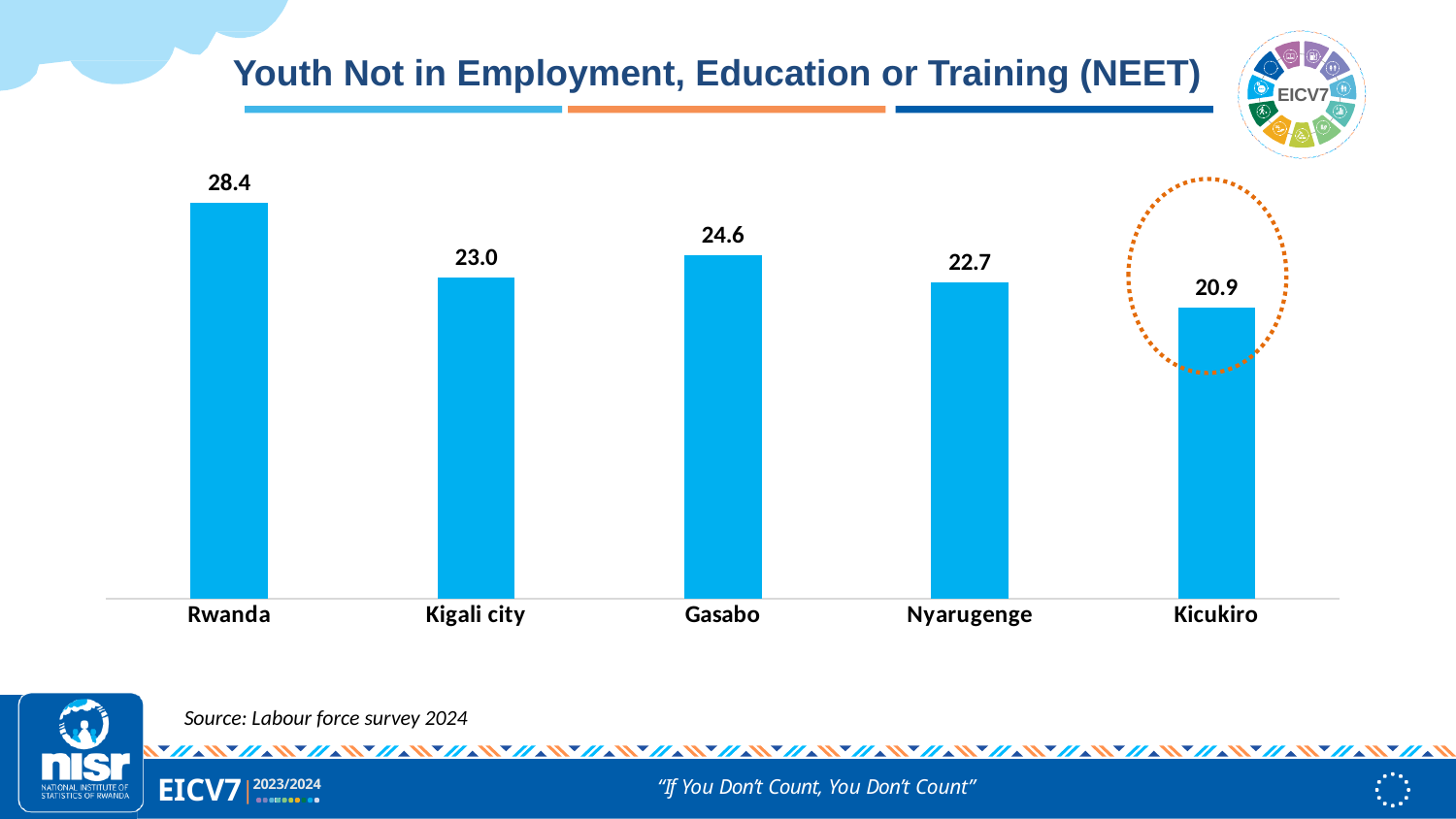
What is the NEET value for Kicukiro? 20.9 What type of chart is shown on the slide? Bar chart What is the difference between the NEET values for Gasabo and Nyarugenge? 1.9 What is the NEET value for Kigali city? 23.0 Which category has the lowest NEET value? Kicukiro How many categories are shown in the chart? 5 What is the NEET value for Gasabo? 24.6 What is the difference between the NEET values for Rwanda and Kicukiro? 7.5 Which has a larger NEET value, Gasabo or Kigali city? Gasabo What is the NEET value for Nyarugenge? 22.7 What is the NEET value for Rwanda? 28.4 Which category has the highest NEET value? Rwanda